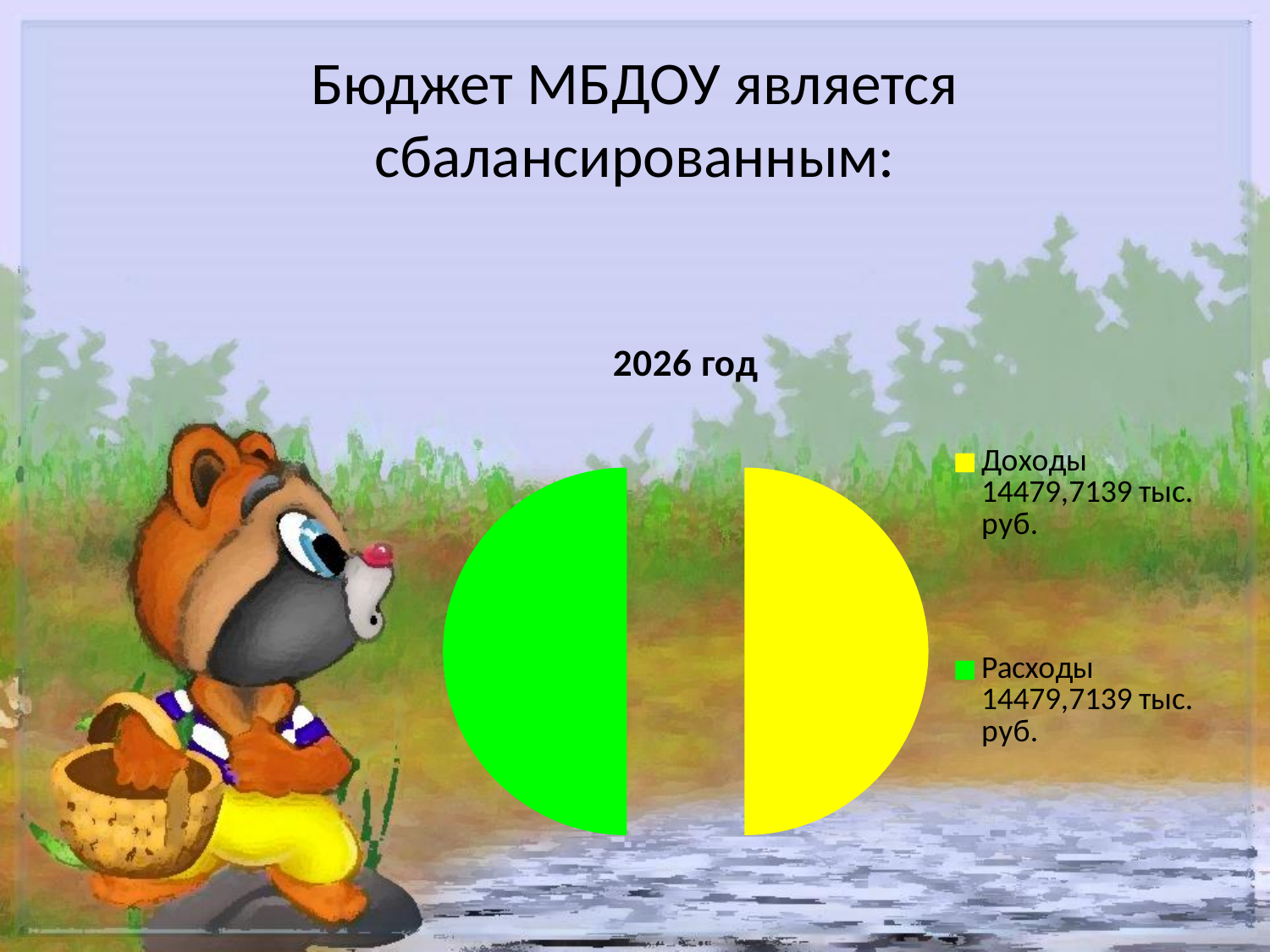
What is the title of the chart? 2026 год What kind of chart is shown on the slide? pie chart Which colour represents Расходы in the pie chart? green How many entries does the chart legend list? 2 How many slices does the pie chart have? 2 What share of the pie does the Доходы slice represent? 50% What is the value for Доходы shown in the legend? 14479,7139 тыс. руб. What is the difference between the values for Доходы and Расходы? 0 What is the value for Расходы shown in the legend? 14479,7139 тыс. руб. What share of the pie does the Расходы slice represent? 50%